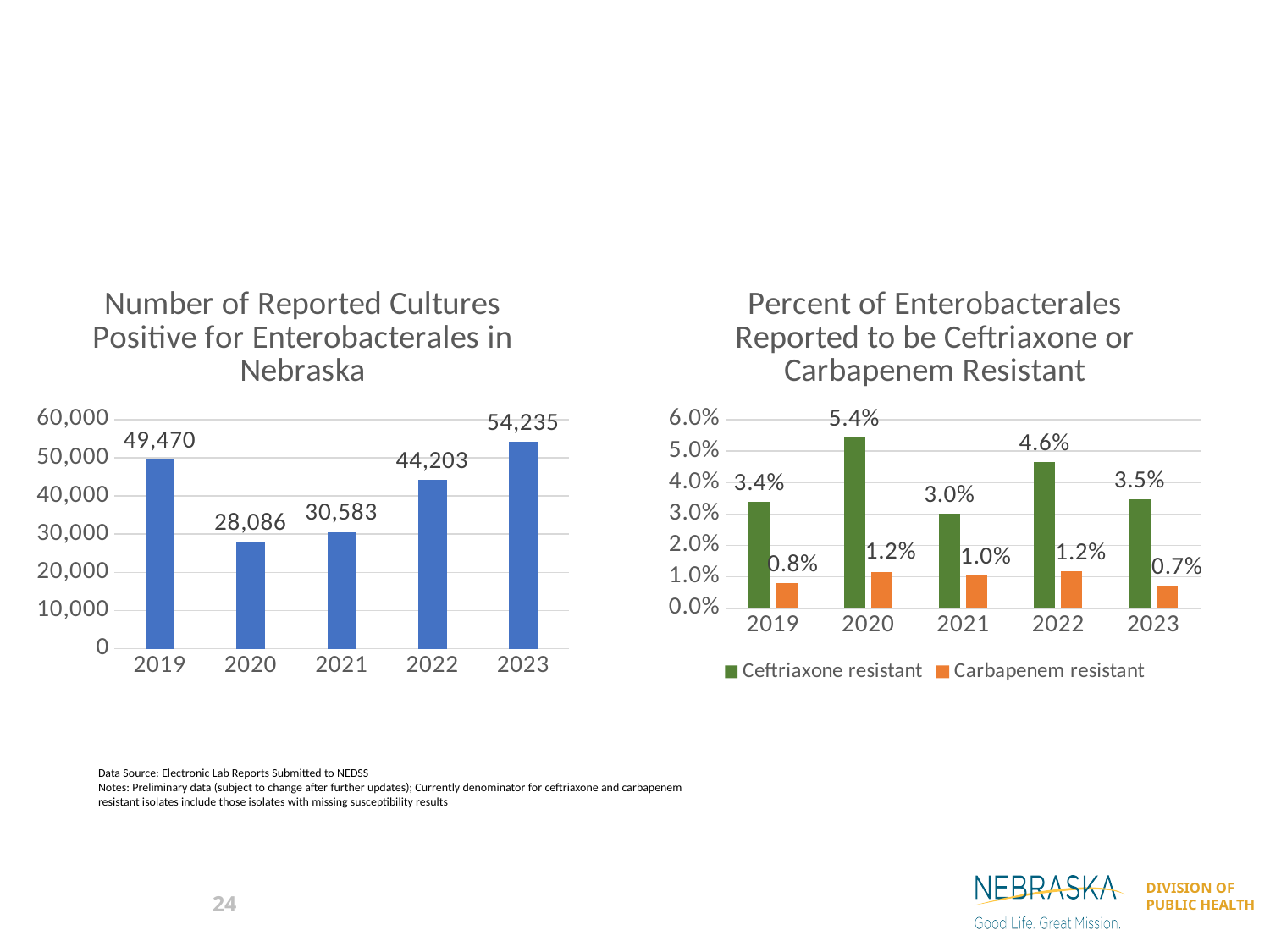
In the 'Percent of Enterobacterales Reported to be Ceftriaxone or Carbapenem Resistant' chart, what is the difference between the Ceftriaxone resistant and Carbapenem resistant values for 2020? 4.2% In the 'Number of Reported Cultures Positive for Enterobacterales in Nebraska' chart, which year has the highest value? 2023 In the 'Percent of Enterobacterales Reported to be Ceftriaxone or Carbapenem Resistant' chart, how many series does the legend list? 2 In the 'Percent of Enterobacterales Reported to be Ceftriaxone or Carbapenem Resistant' chart, which colour represents Carbapenem resistant? Orange In the 'Number of Reported Cultures Positive for Enterobacterales in Nebraska' chart, what is the difference between the 2023 and 2022 values? 10,032 In the 'Percent of Enterobacterales Reported to be Ceftriaxone or Carbapenem Resistant' chart, what is the Ceftriaxone resistant value for 2022? 4.6% In the 'Percent of Enterobacterales Reported to be Ceftriaxone or Carbapenem Resistant' chart, which year has the highest Ceftriaxone resistant value? 2020 What kind of chart is the 'Number of Reported Cultures Positive for Enterobacterales in Nebraska' chart? Bar chart In the 'Percent of Enterobacterales Reported to be Ceftriaxone or Carbapenem Resistant' chart, what is the Carbapenem resistant value for 2023? 0.7% In the 'Number of Reported Cultures Positive for Enterobacterales in Nebraska' chart, what is the value for 2021? 30,583 In the 'Number of Reported Cultures Positive for Enterobacterales in Nebraska' chart, which year has the lowest value? 2020 In the 'Number of Reported Cultures Positive for Enterobacterales in Nebraska' chart, how many years are shown? 5